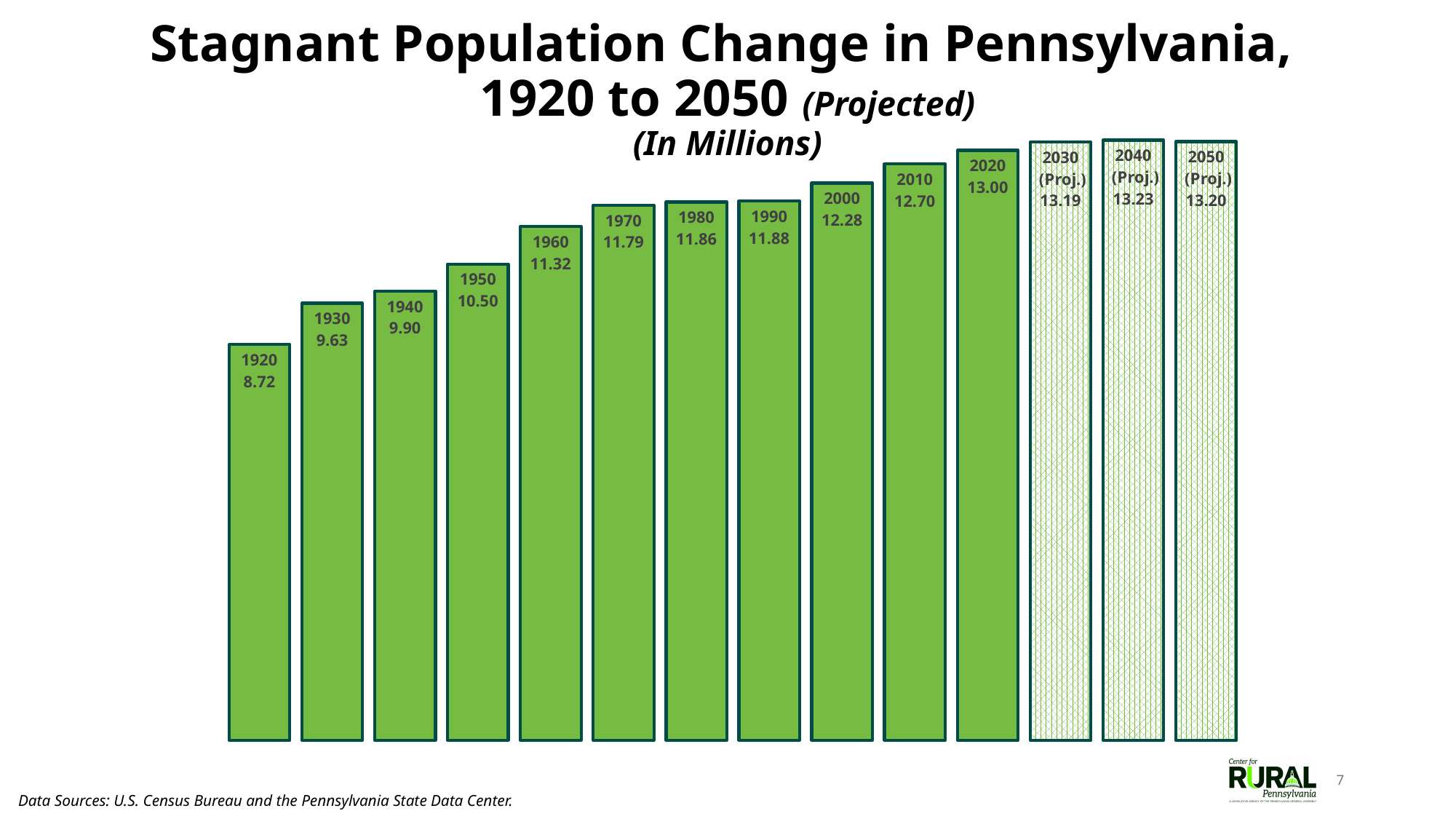
How many bars are shown on the chart? 14 What is the projected population value shown for 2040? 13.23 What kind of chart is shown on the slide? Bar chart What is the difference between the 2020 value and the 1920 value? 4.28 What is the difference between the 2010 value and the 2000 value? 0.42 Do the values generally rise or fall from 1920 to 2020? Rise What is the population value shown for 1920? 8.72 Which is larger, the value for 1960 or the value for 1950? 1960 How many of the bars are labelled as projected (Proj.)? 3 What is the population value shown for 2020? 13.00 Which year has the lowest population value on the chart? 1920 Which year has the highest population value on the chart? 2040 (Proj.)